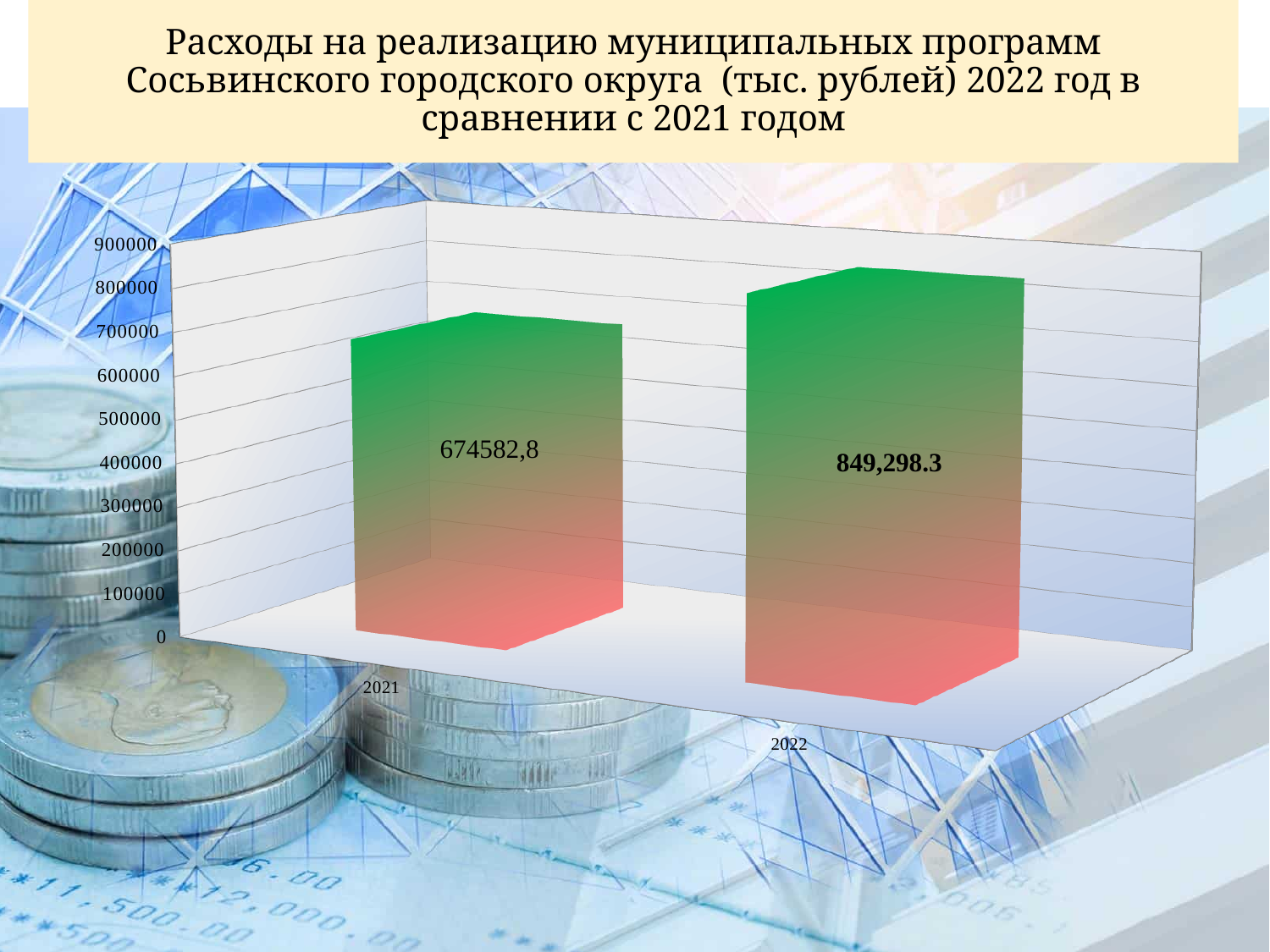
Is the value for 2022 greater or less than 800000? greater Is the value for 2021 greater or less than 600000? greater Do the values rise or fall from 2021 to 2022? rise What is the value shown for 2022? 849,298.3 What is the value shown for 2021? 674582,8 Is the value for 2022 larger or smaller than the value for 2021? larger What is the highest value labelled on the vertical axis? 900000 Which year has the higher expenditure value? 2022 How many years (categories) are shown on the chart? 2 In what units are the expenditures given according to the slide title? тыс. рублей What kind of chart is shown on the slide? bar chart Which year has the lower expenditure value? 2021